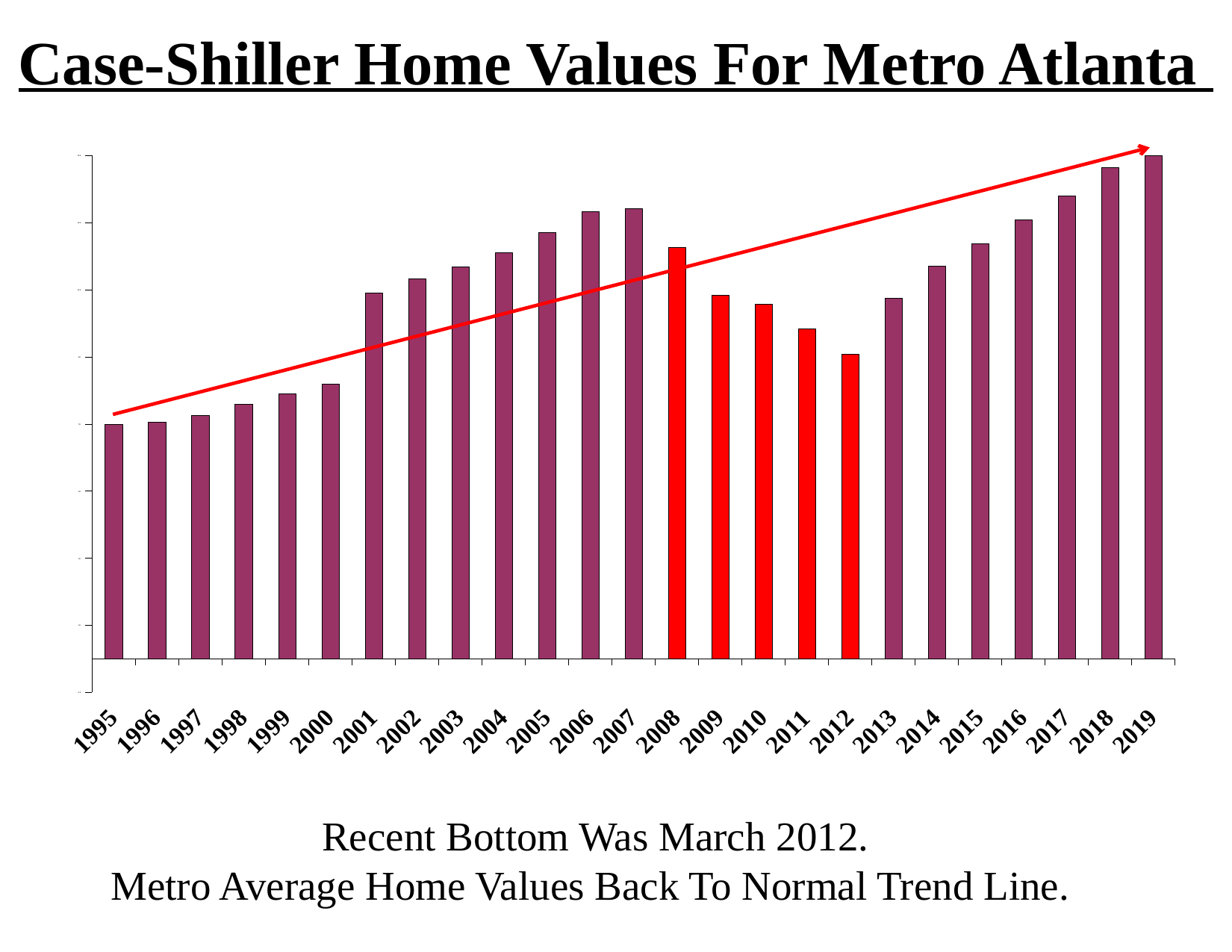
Which years are shown with bright red bars in the chart? 2008, 2009, 2010, 2011, 2012 Which is larger, the value for 2000 or the value for 2001? 2001 What is the title of the chart on the slide? Case-Shiller Home Values For Metro Atlanta Do the values rise or fall from 2012 to 2019? Rise Which year has the highest bar in the chart? 2019 Which year has the highest bar among the years 1995 to 2007? 2007 Which year has the lowest bar among the red-highlighted bars? 2012 How many years are plotted along the x axis of the chart? 25 Which is larger, the value for 2007 or the value for 2008? 2007 Do the values rise or fall from 2007 to 2012? Fall Which is larger, the value for 2012 or the value for 2013? 2013 What kind of chart is shown on the slide? Bar chart